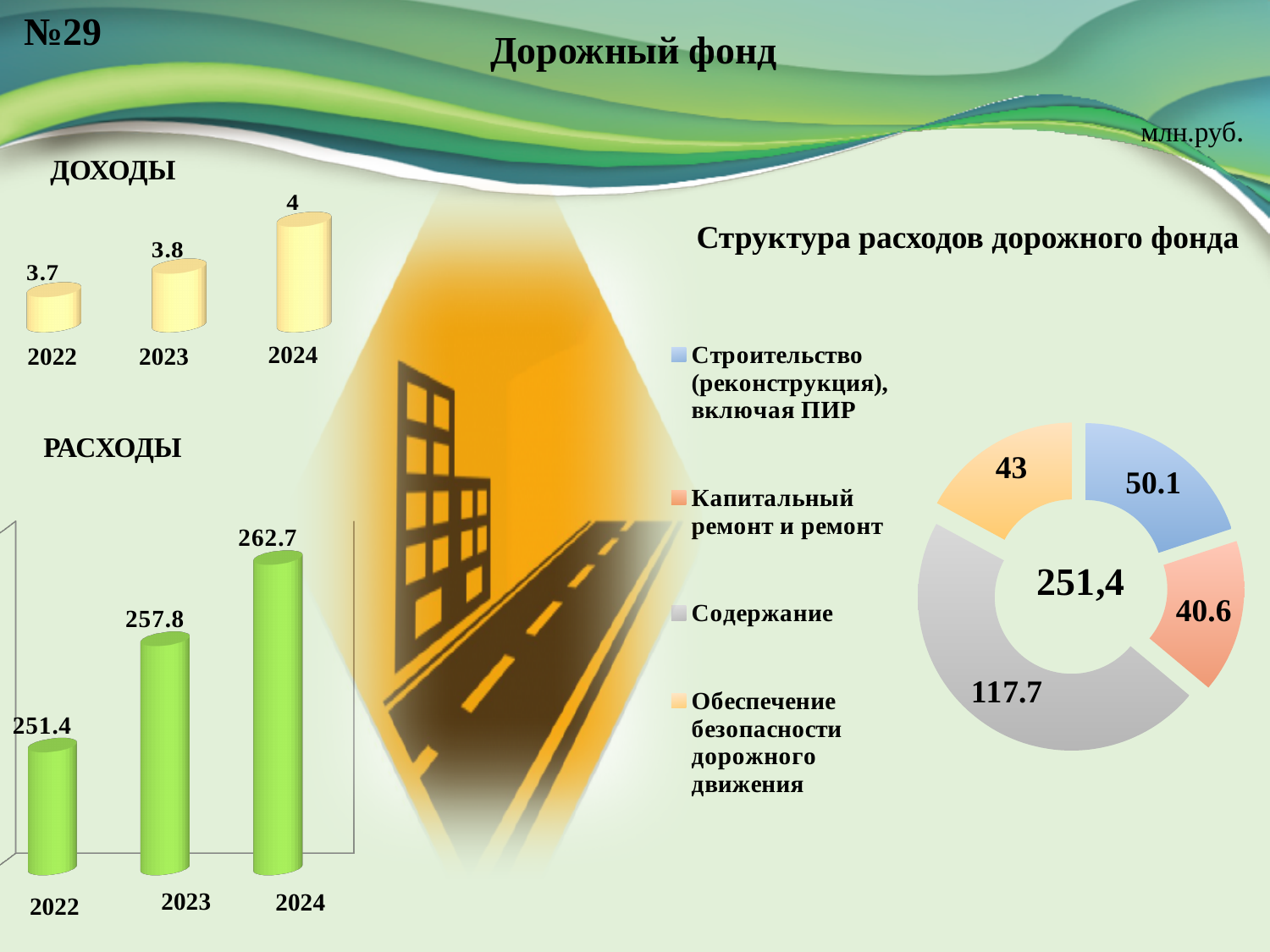
In the Структура расходов дорожного фонда chart, how many categories does the legend list? 4 In the ДОХОДЫ chart, which year has the lowest value? 2022 In the РАСХОДЫ chart, what is the difference between the 2024 and 2022 values? 11.3 In the РАСХОДЫ chart, which year has the highest value? 2024 In the ДОХОДЫ chart, what is the value for 2024? 4 In the ДОХОДЫ chart, do the values rise or fall from 2022 to 2024? rise In the РАСХОДЫ chart, how many years are shown? 3 In the Структура расходов дорожного фонда chart, which is larger: Строительство (реконструкция), включая ПИР or Обеспечение безопасности дорожного движения? Строительство (реконструкция), включая ПИР What kind of chart is the Структура расходов дорожного фонда chart? doughnut chart In the РАСХОДЫ chart, what is the value for 2023? 257.8 In the Структура расходов дорожного фонда chart, what is the value for Содержание? 117.7 In the Структура расходов дорожного фонда chart, which category has the smallest value? Капитальный ремонт и ремонт